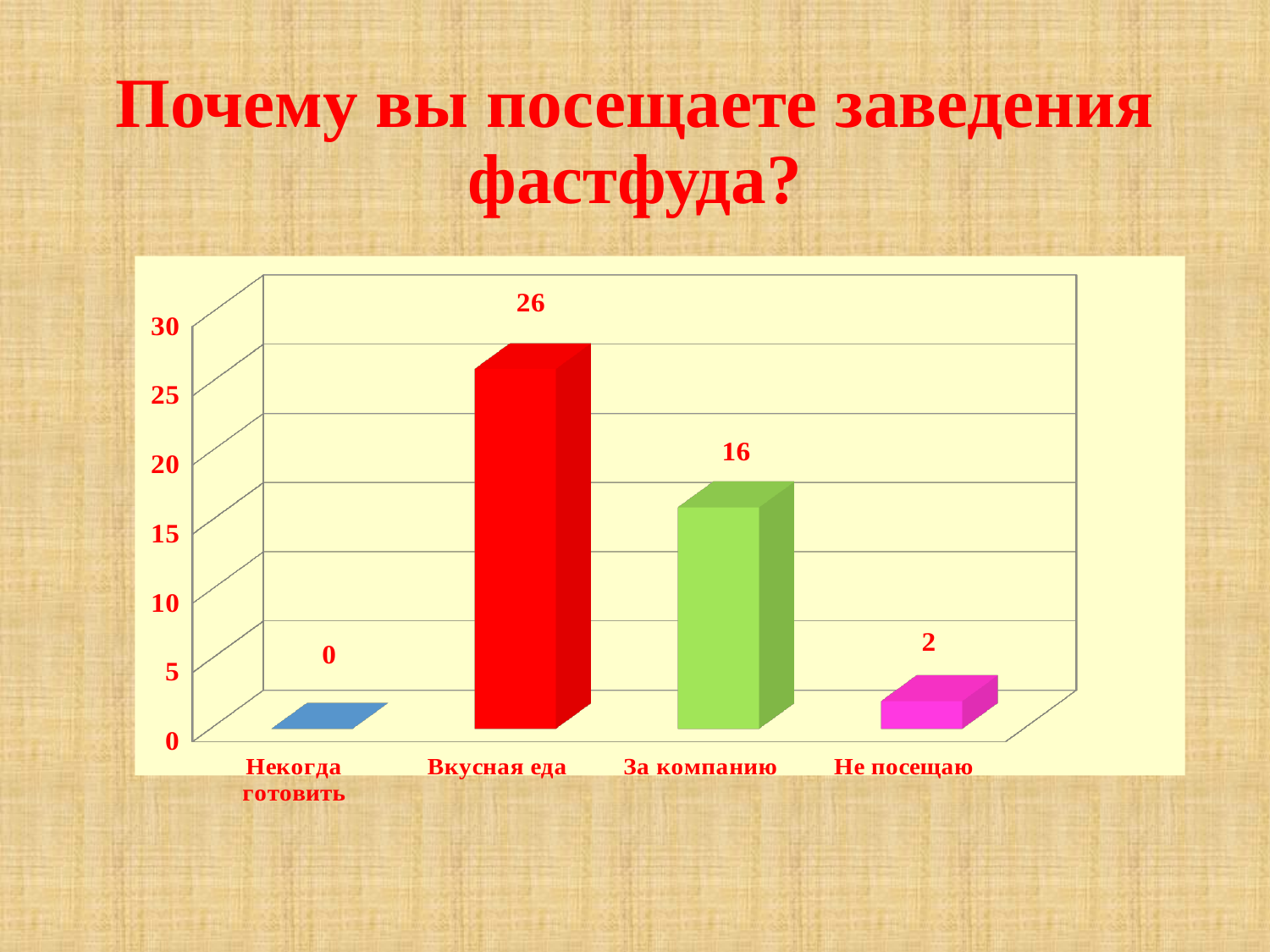
Which category has the highest value? Вкусная еда Which category has the lowest value? Некогда готовить Which is larger, the value for За компанию or the value for Не посещаю? За компанию What is the title of the slide? Почему вы посещаете заведения фастфуда? What is the value for За компанию? 16 What kind of chart is shown on the slide? bar chart Is the value for Вкусная еда greater or less than 20? greater How many categories are shown on the chart? 4 What is the value for Вкусная еда? 26 What is the difference between the values for Вкусная еда and За компанию? 10 What is the value for Не посещаю? 2 What is the value for Некогда готовить? 0